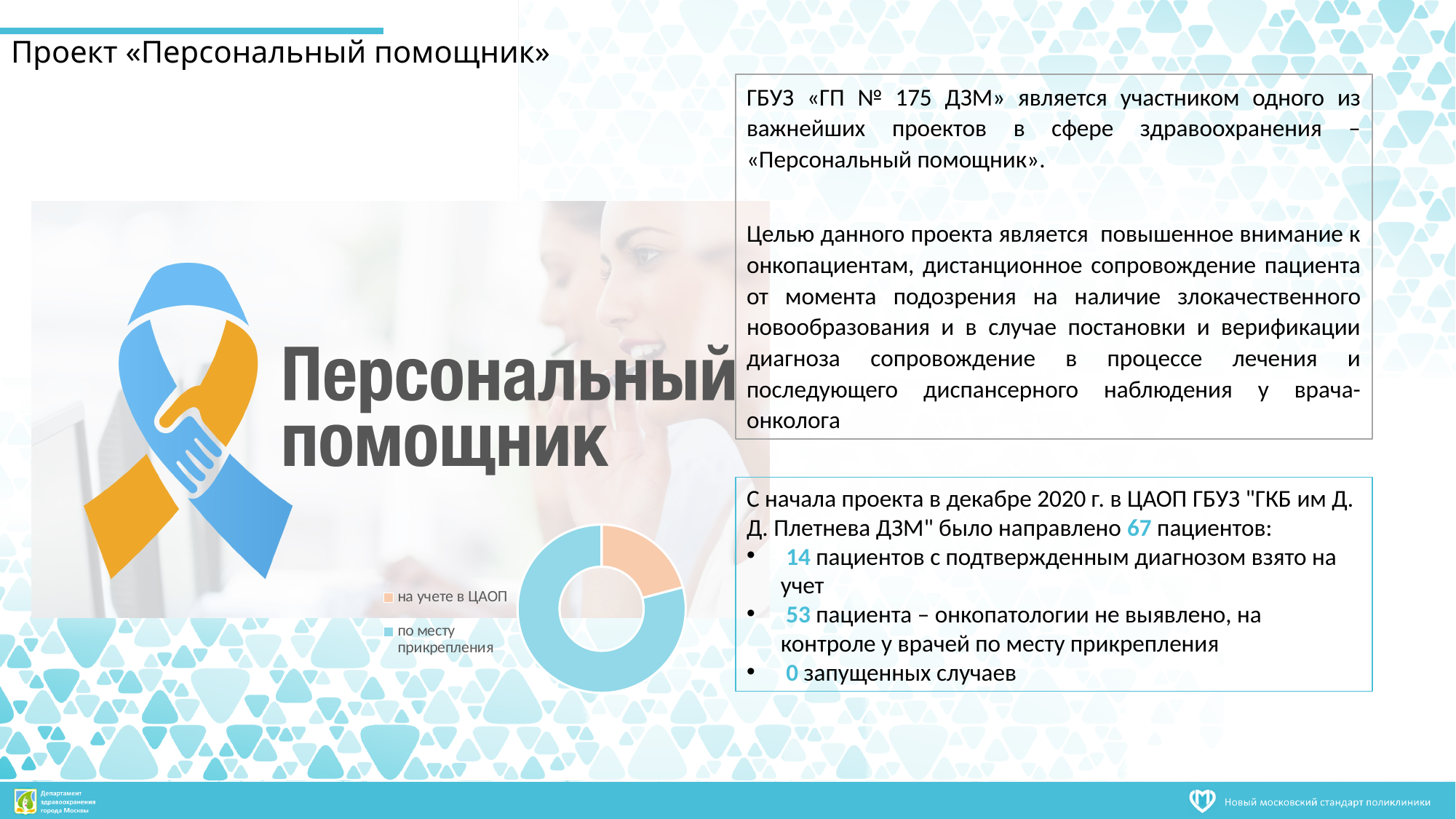
What kind of chart is shown on the slide? Donut chart Which category takes up the largest part of the donut chart? по месту прикрепления Which slice is larger in the donut chart: "на учете в ЦАОП" or "по месту прикрепления"? по месту прикрепления How many slices does the donut chart have? 2 How many entries does the legend of the donut chart list? 2 Which category takes up the smallest part of the donut chart? на учете в ЦАОП What colour is the "на учете в ЦАОП" slice in the donut chart? Orange What colour is the "по месту прикрепления" slice in the donut chart? Blue